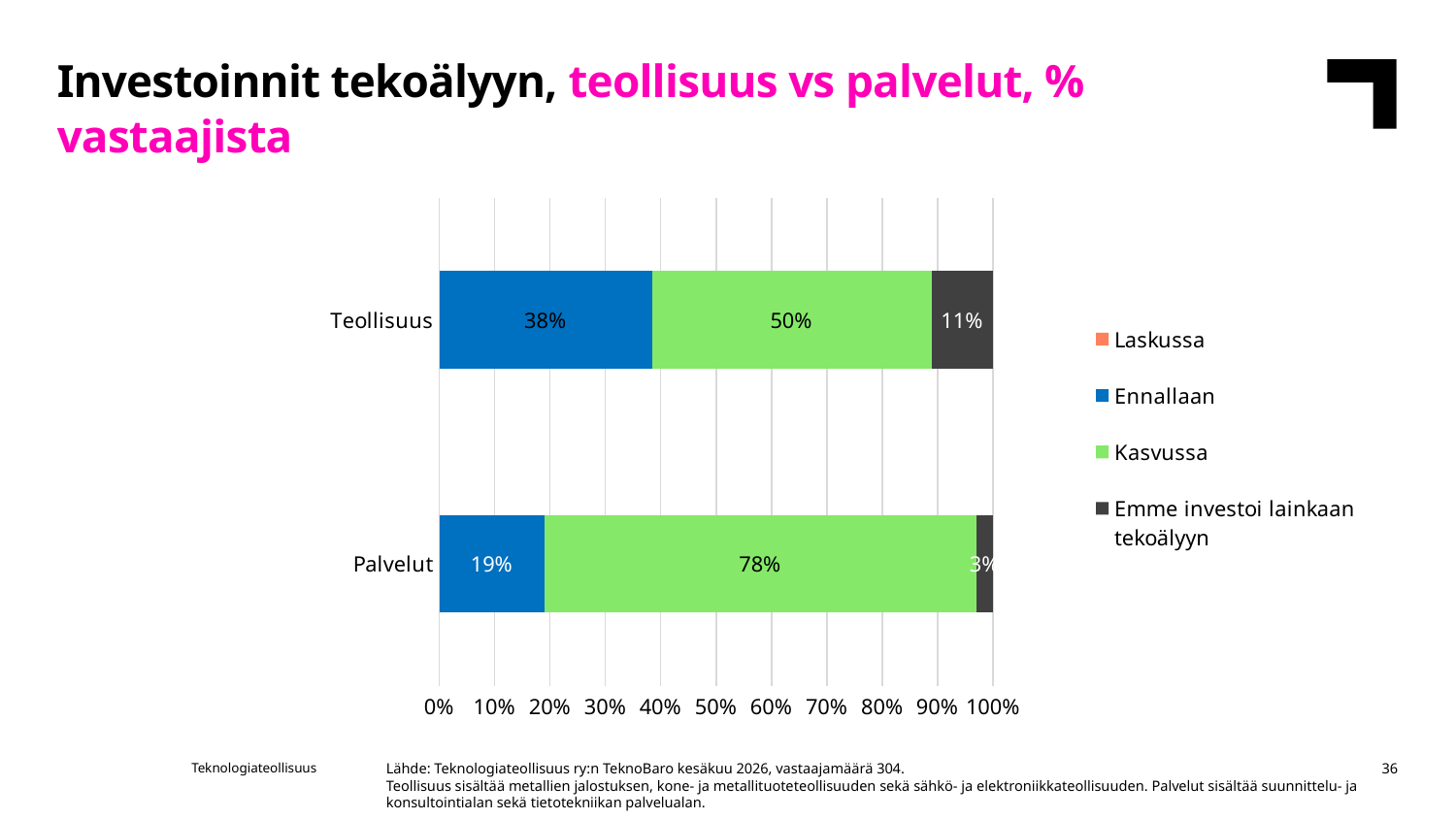
What is the value of the Ennallaan segment for Palvelut? 19% What is the value of the 'Emme investoi lainkaan tekoälyyn' segment for Teollisuus? 11% Which category has the higher Ennallaan value? Teollisuus What kind of chart is shown on the slide? Stacked horizontal bar chart What is the total of the printed segments in the Palvelut bar? 100% What is the difference between the Kasvussa values for Palvelut and Teollisuus? 28 percentage points What is the value of the Kasvussa segment for Teollisuus? 50% How many categories are shown on the chart? 2 Which category has the larger Kasvussa share, Teollisuus or Palvelut? Palvelut What is the value of the Kasvussa segment for Palvelut? 78% What is the difference between the Ennallaan values for Teollisuus and Palvelut? 19 percentage points How many series does the legend list? 4